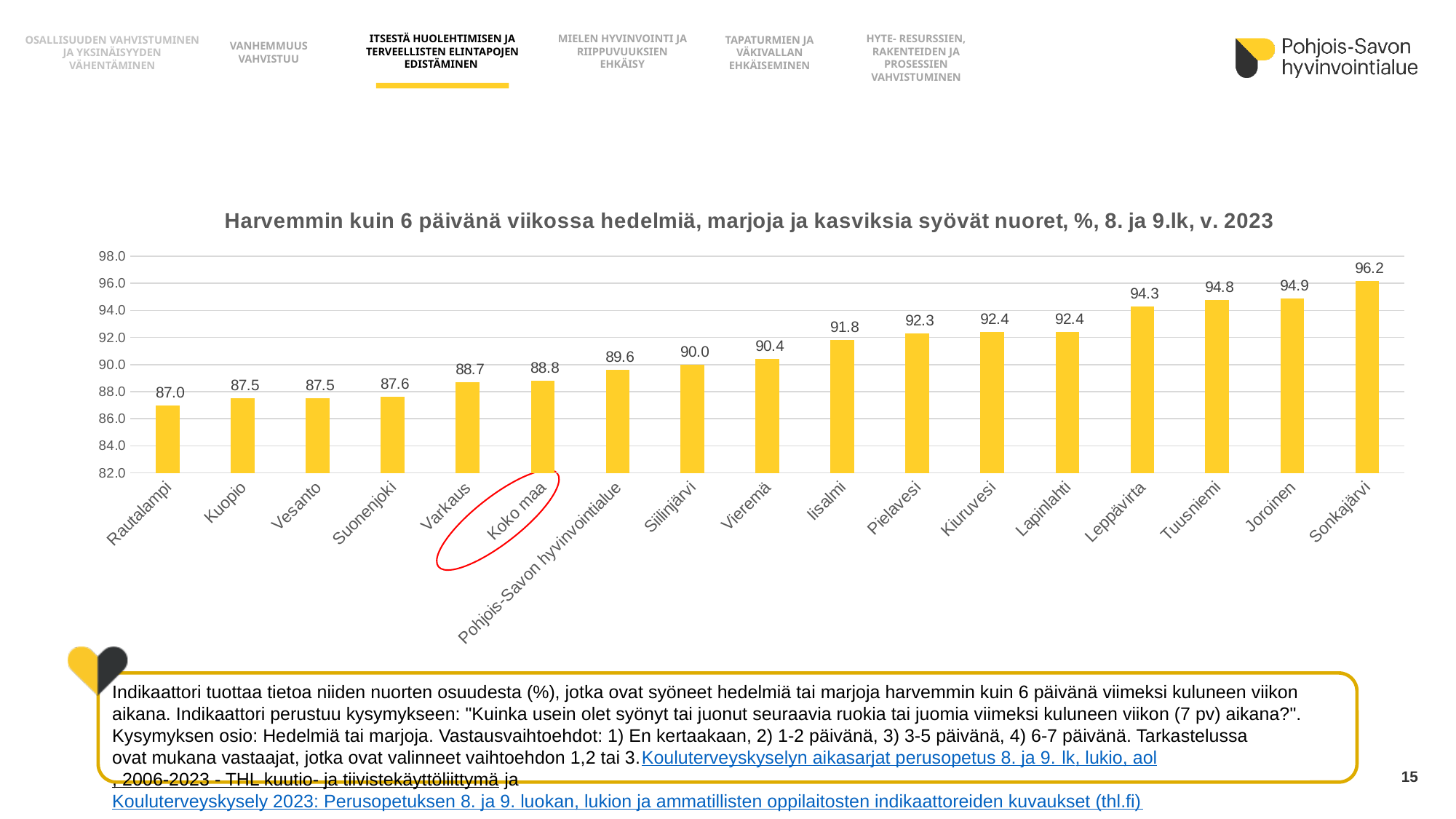
What is the value for Kuopio? 87.5 What is the difference between the values for Pohjois-Savon hyvinvointialue and Koko maa? 0.8 What is the value for Leppävirta? 94.3 What is the difference between the values for Sonkajärvi and Rautalampi? 9.2 What is the value for Pohjois-Savon hyvinvointialue? 89.6 Do the values rise or fall from left to right along the x axis? Rise Which category has the highest value? Sonkajärvi Which category has the lowest value? Rautalampi Which is larger, the value for Iisalmi or the value for Vieremä? Iisalmi What is the value for Koko maa? 88.8 How many categories are shown on the x axis? 17 What kind of chart is shown on the slide? Bar chart